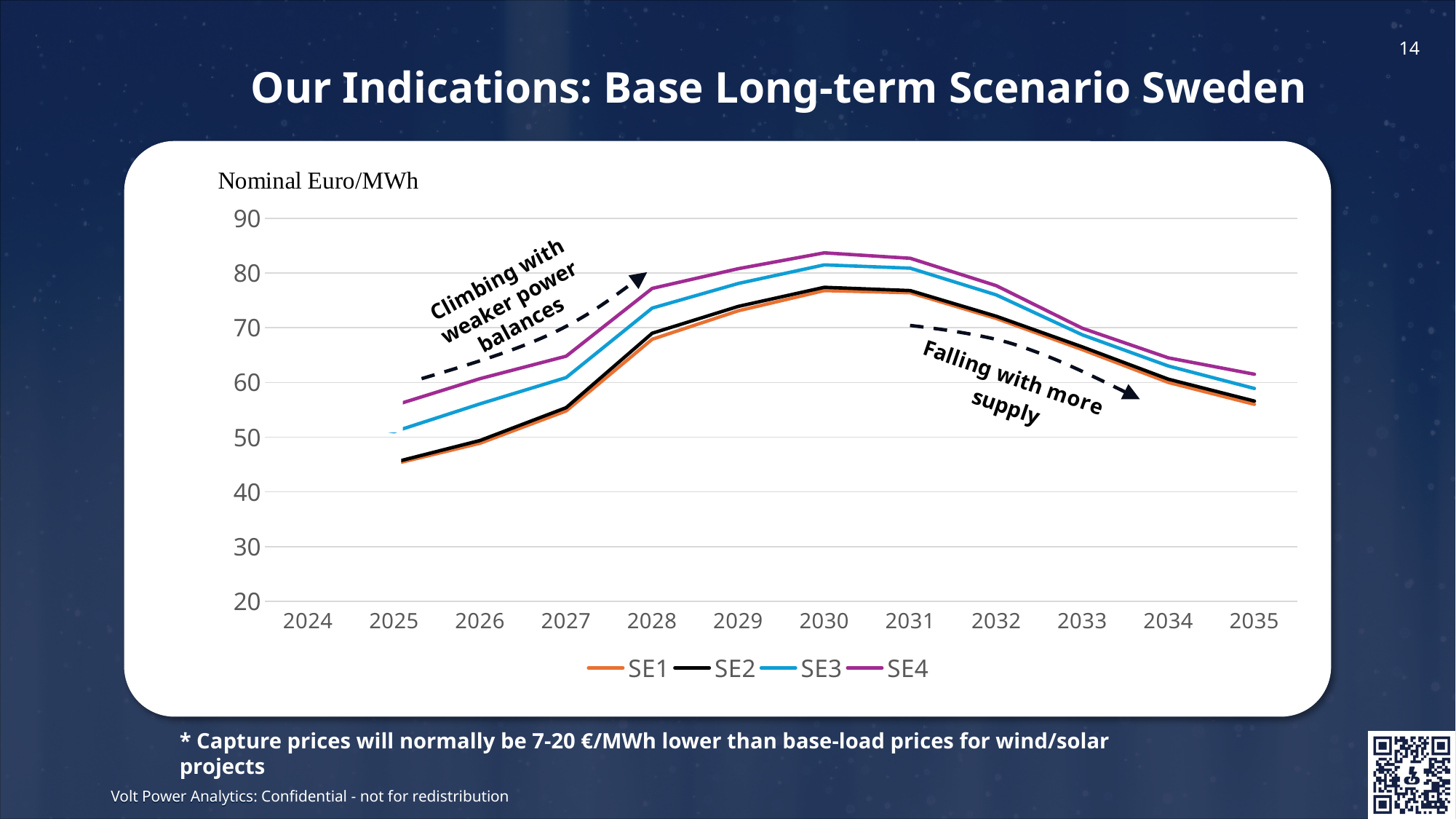
Do the lines rise or fall between 2030 and 2035? fall What kind of chart is shown on the slide? line chart Is the value for SE3 in 2028 greater or less than 70? greater What unit is given for the y axis? Nominal Euro/MWh Which is larger in 2028, the value for SE3 or the value for SE2? SE3 Is the value for SE4 in 2030 greater or less than 80? greater Is the value for SE1 in 2035 greater or less than 60? less Which series has the highest values across the whole period? SE4 In which year does the SE4 line reach its peak? 2030 How many series does the legend list? 4